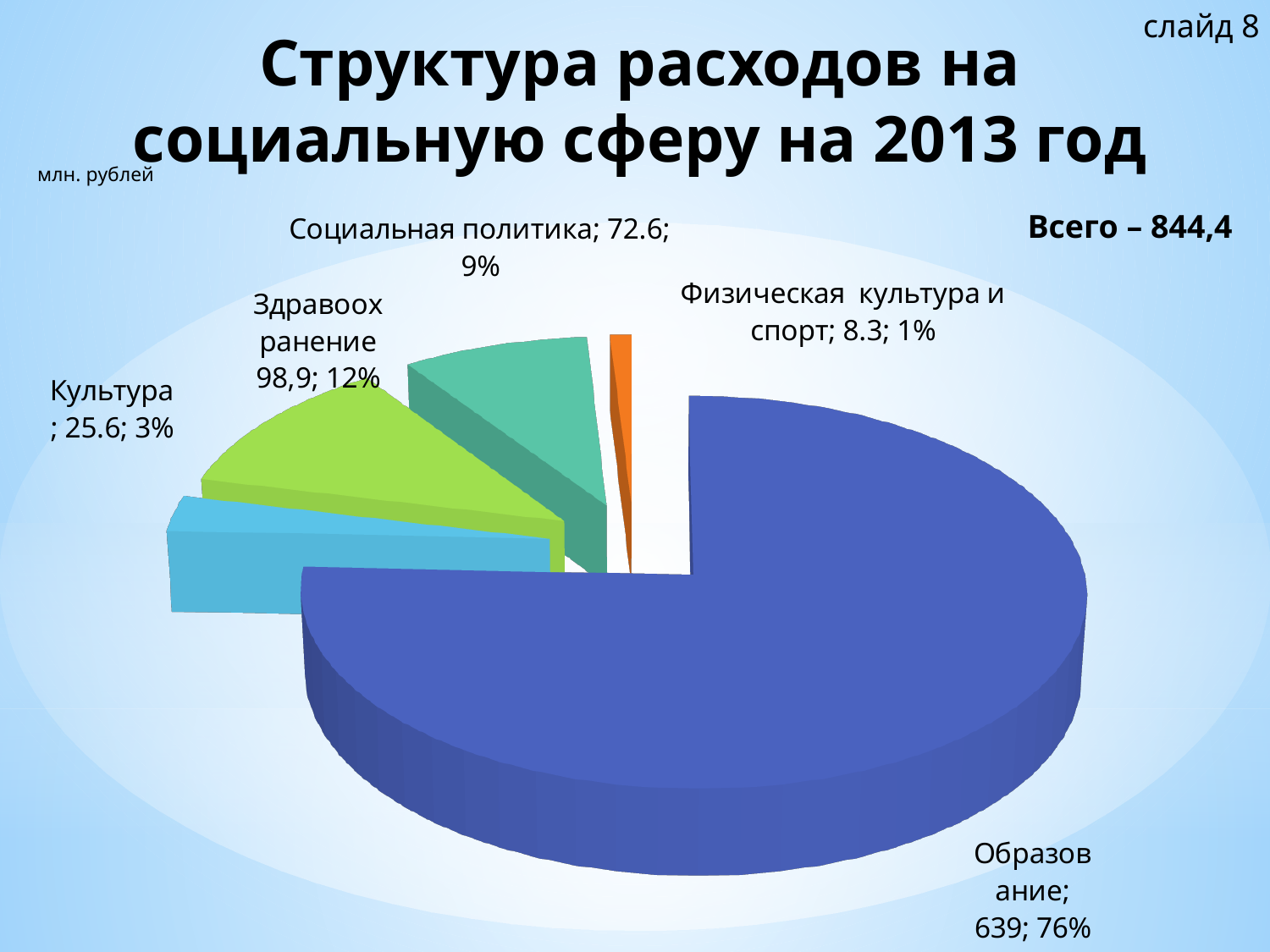
Which category has the smallest slice? Физическая культура и спорт What is the value for Здравоохранение? 98,9 What total value is stated on the slide (Всего)? 844,4 What kind of chart is shown on the slide? pie chart Which is larger, Здравоохранение or Социальная политика? Здравоохранение What is the value for Физическая культура и спорт? 8.3 What is the value for Социальная политика? 72.6 What share of the pie does Культура represent? 3% How many slices does the pie chart have? 5 What is the value for Образование? 639 Which category has the largest slice? Образование What share of the pie does Образование represent? 76%